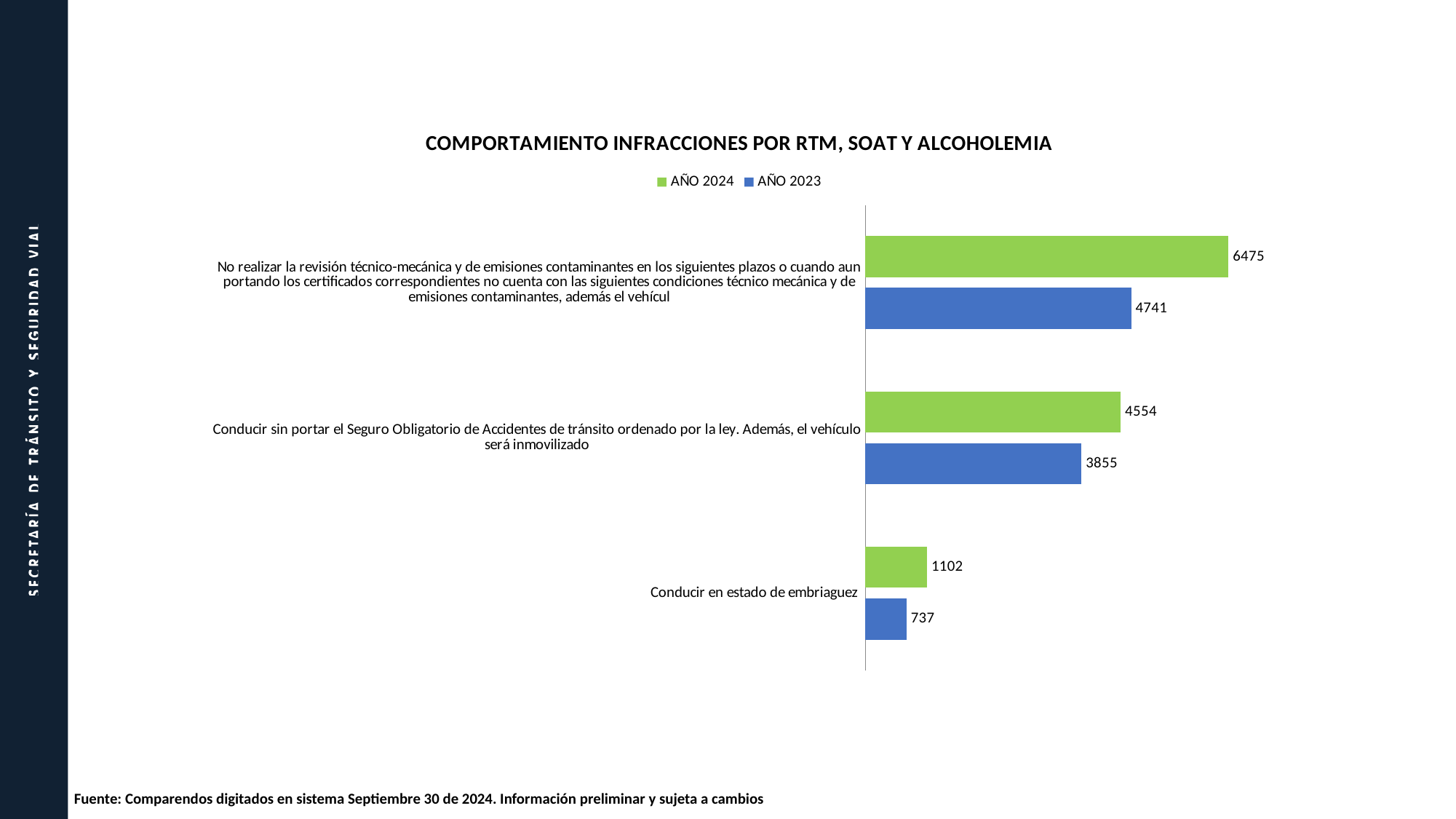
What is the AÑO 2023 value for the category about not performing the técnico-mecánica revision? 4741 What is the AÑO 2023 value for 'Conducir en estado de embriaguez'? 737 What type of chart is shown on the slide? Bar chart How many series does the legend list? 2 What is the AÑO 2024 value for 'Conducir en estado de embriaguez'? 1102 Which category has the highest AÑO 2024 value? No realizar la revisión técnico-mecánica y de emisiones contaminantes What is the AÑO 2024 value for 'Conducir sin portar el Seguro Obligatorio de Accidentes de tránsito'? 4554 What is the difference between the AÑO 2024 and AÑO 2023 values for 'Conducir sin portar el Seguro Obligatorio'? 699 Which category has the lowest AÑO 2023 value? Conducir en estado de embriaguez For 'Conducir en estado de embriaguez', which year has the larger value, AÑO 2024 or AÑO 2023? AÑO 2024 How many categories are shown on the chart? 3 What is the difference between the AÑO 2024 and AÑO 2023 values for the técnico-mecánica revision category? 1734